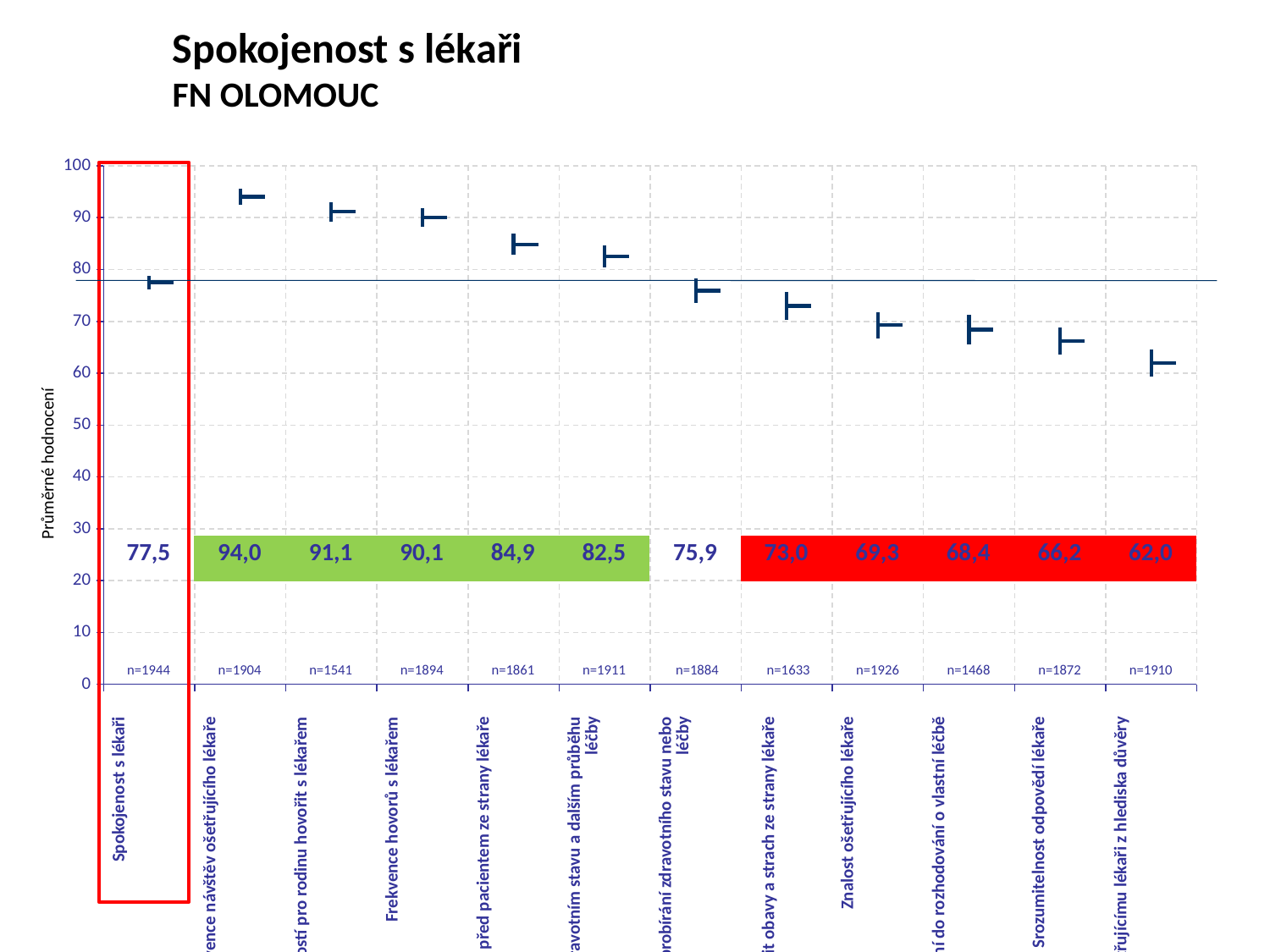
What is the value for Srozumitelnost odpovědí lékaře? 66,2 What is the value for Frekvence hovorů s lékařem? 90,1 Is the value for Znalost ošetřujícího lékaře greater or less than 70? less Which is larger: the value for Spokojenost s lékaři or the value for Srozumitelnost odpovědí lékaře? Spokojenost s lékaři How many categories are plotted in the chart? 12 What is the title of the chart? Spokojenost s lékaři What is the value for Spokojenost s lékaři? 77,5 What is the value for Znalost ošetřujícího lékaře? 69,3 What is the sample size (n) shown for Spokojenost s lékaři? n=1944 What is the highest value shown in the chart? 94,0 What is the difference between the value for Frekvence hovorů s lékařem and the value for Znalost ošetřujícího lékaře? 20,8 What is the lowest value shown in the chart? 62,0